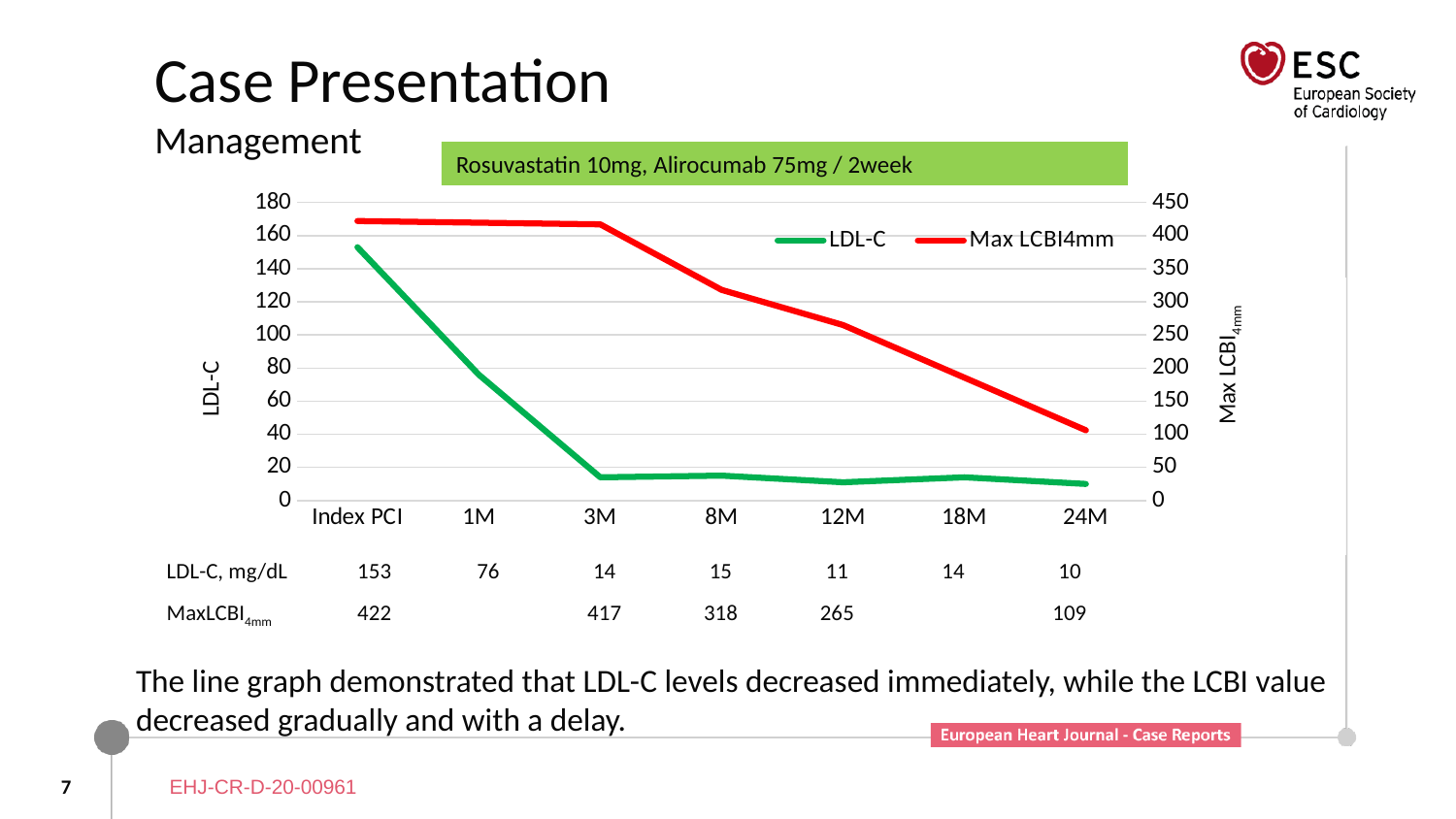
How many time points are shown on the x axis? 7 At which time point is MaxLCBI4mm highest? Index PCI What is the difference between the LDL-C value at Index PCI and at 1M? 77 At which time point is LDL-C lowest? 24M What is the MaxLCBI4mm value at 8M? 318 What is the LDL-C value at 1M? 76 What is the LDL-C value at Index PCI? 153 How many series does the chart legend list? 2 What is the difference between the MaxLCBI4mm value at Index PCI and at 24M? 313 Which is larger, the MaxLCBI4mm value at 3M or at 12M? 3M What is the MaxLCBI4mm value at 24M? 109 What type of chart is shown on the slide? line chart